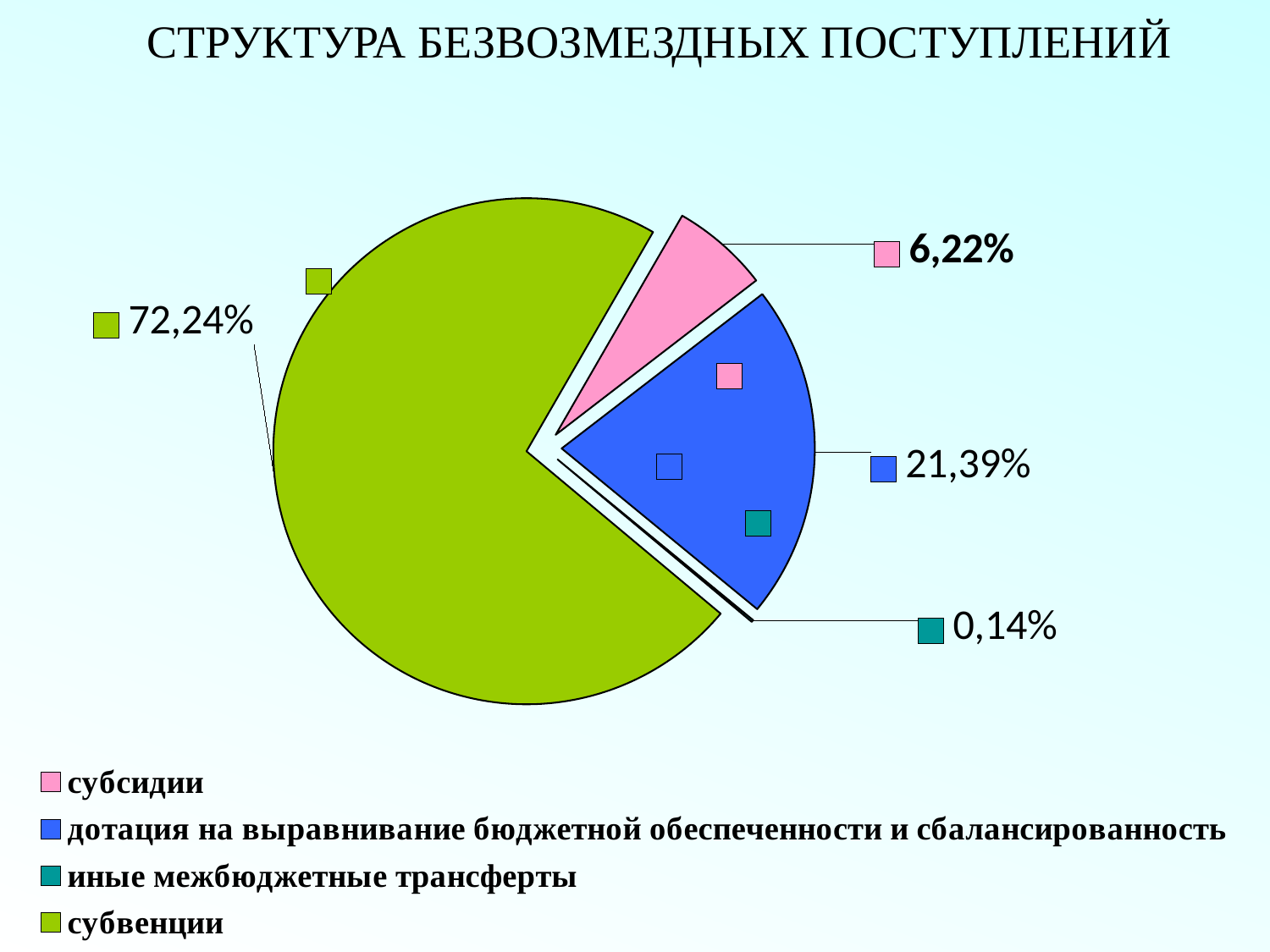
Which is larger: the share of субсидии or the share of дотация на выравнивание бюджетной обеспеченности и сбалансированность? дотация на выравнивание бюджетной обеспеченности и сбалансированность Which category has the largest share of the pie? субвенции How many slices does the pie chart have? 4 What is the difference between the share of субвенции and the share of дотация на выравнивание бюджетной обеспеченности и сбалансированность? 50,85% What colour is the slice for субсидии? pink Which category has the smallest share of the pie? иные межбюджетные трансферты What is the share of субвенции in the pie chart? 72,24% What is the share of иные межбюджетные трансферты? 0,14% What is the share of дотация на выравнивание бюджетной обеспеченности и сбалансированность? 21,39% What is the title of the chart? СТРУКТУРА БЕЗВОЗМЕЗДНЫХ ПОСТУПЛЕНИЙ What is the share of субсидии in the pie chart? 6,22% What kind of chart is shown on the slide? pie chart